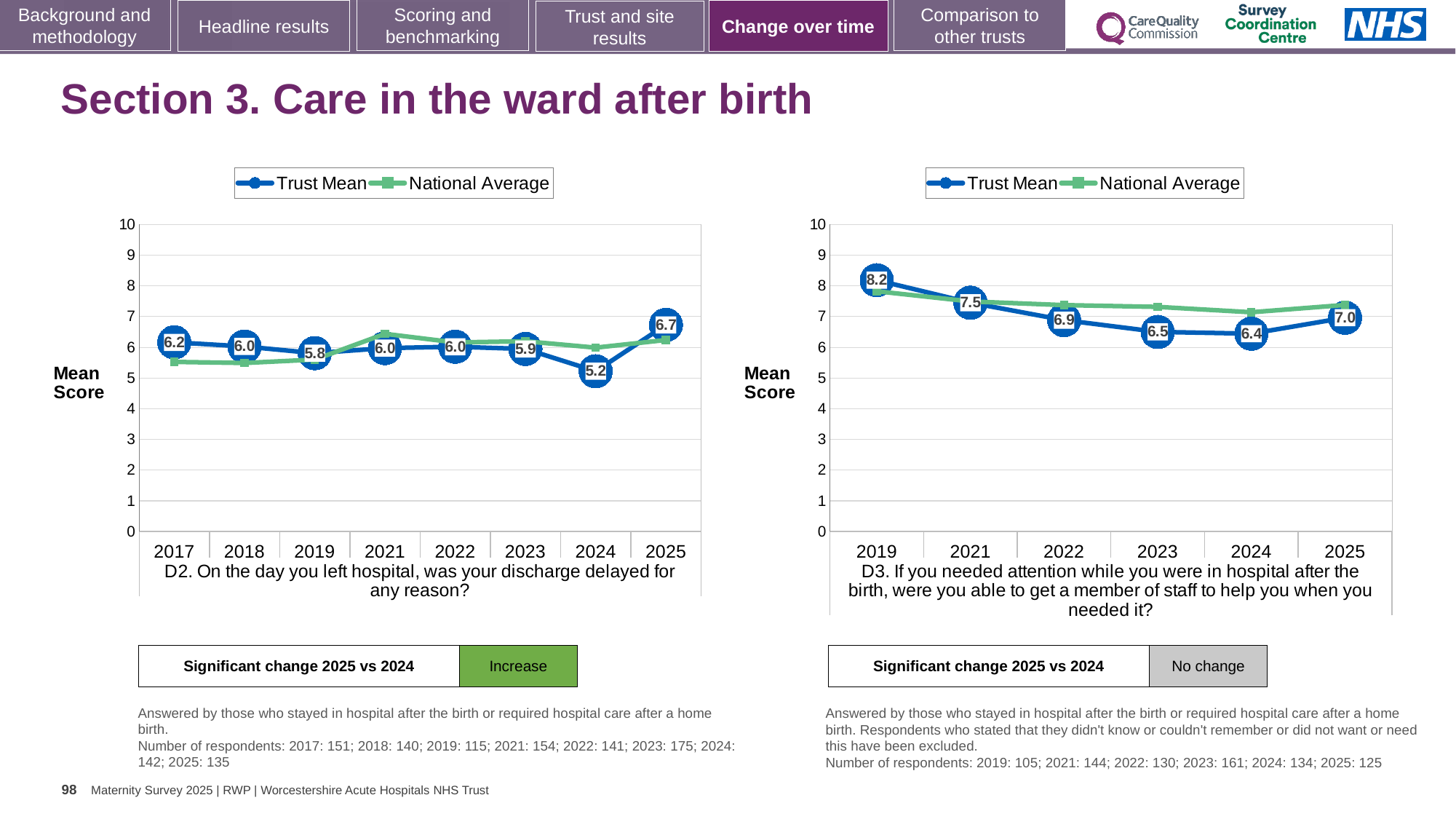
How many series does the legend of the right chart (D3) list? 2 How many years are plotted on the x axis of the left chart (D2)? 8 In the right chart (D3), does the Trust Mean rise or fall from 2019 to 2024? Fall In the left chart (D2), which year has the highest Trust Mean? 2025 In the right chart (D3), is the Trust Mean higher in 2021 or in 2022? 2021 In the left chart (D2), what is the Trust Mean for 2024? 5.2 In the right chart (D3), what is the difference between the Trust Mean for 2019 and 2025? 1.2 In the left chart (D2), what is the difference between the Trust Mean for 2025 and 2024? 1.5 In the right chart (D3), what is the Trust Mean for 2019? 8.2 In the right chart (D3), is the National Average for 2019 greater or less than 7? greater What kind of chart is the left chart (D2)? Line chart In the right chart (D3), which year has the lowest Trust Mean? 2024